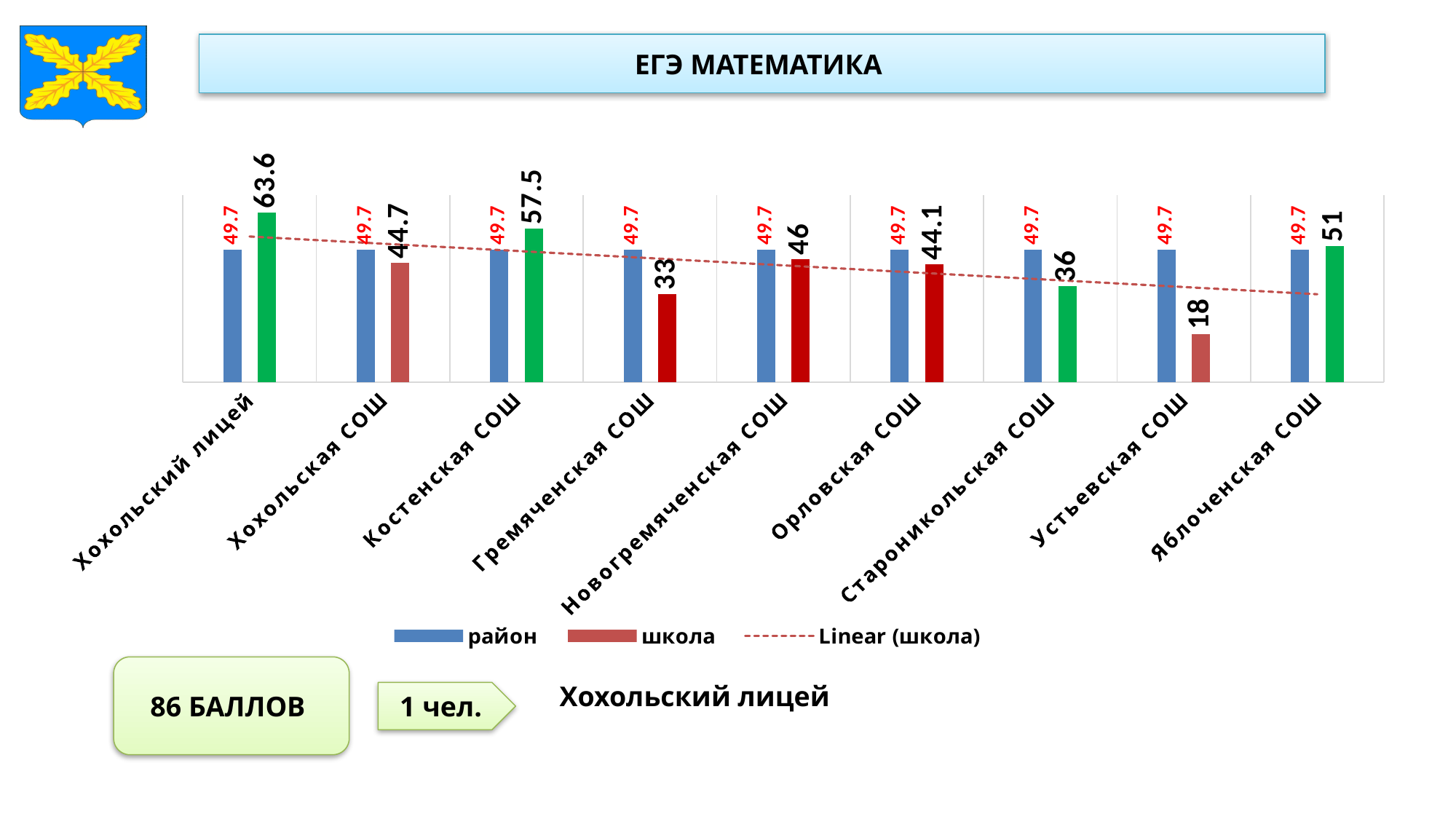
Which is larger, the школа value for Новогремяченская СОШ or for Яблоченская СОШ? Яблоченская СОШ How many entries does the chart legend list? 3 What kind of chart is shown on the slide? bar chart What is the школа value for Хохольский лицей? 63.6 What is the школа value for Устьевская СОШ? 18 Which school has the highest школа value? Хохольский лицей Which school has the lowest школа value? Устьевская СОШ What is the difference between the школа values for Костенская СОШ and Гремяченская СОШ? 24.5 How many schools are shown on the x axis of the chart? 9 What is the title shown above the chart? ЕГЭ МАТЕМАТИКА What is the школа value for Старо­никольская СОШ? 36 What is the район value shown for Орловская СОШ? 49.7